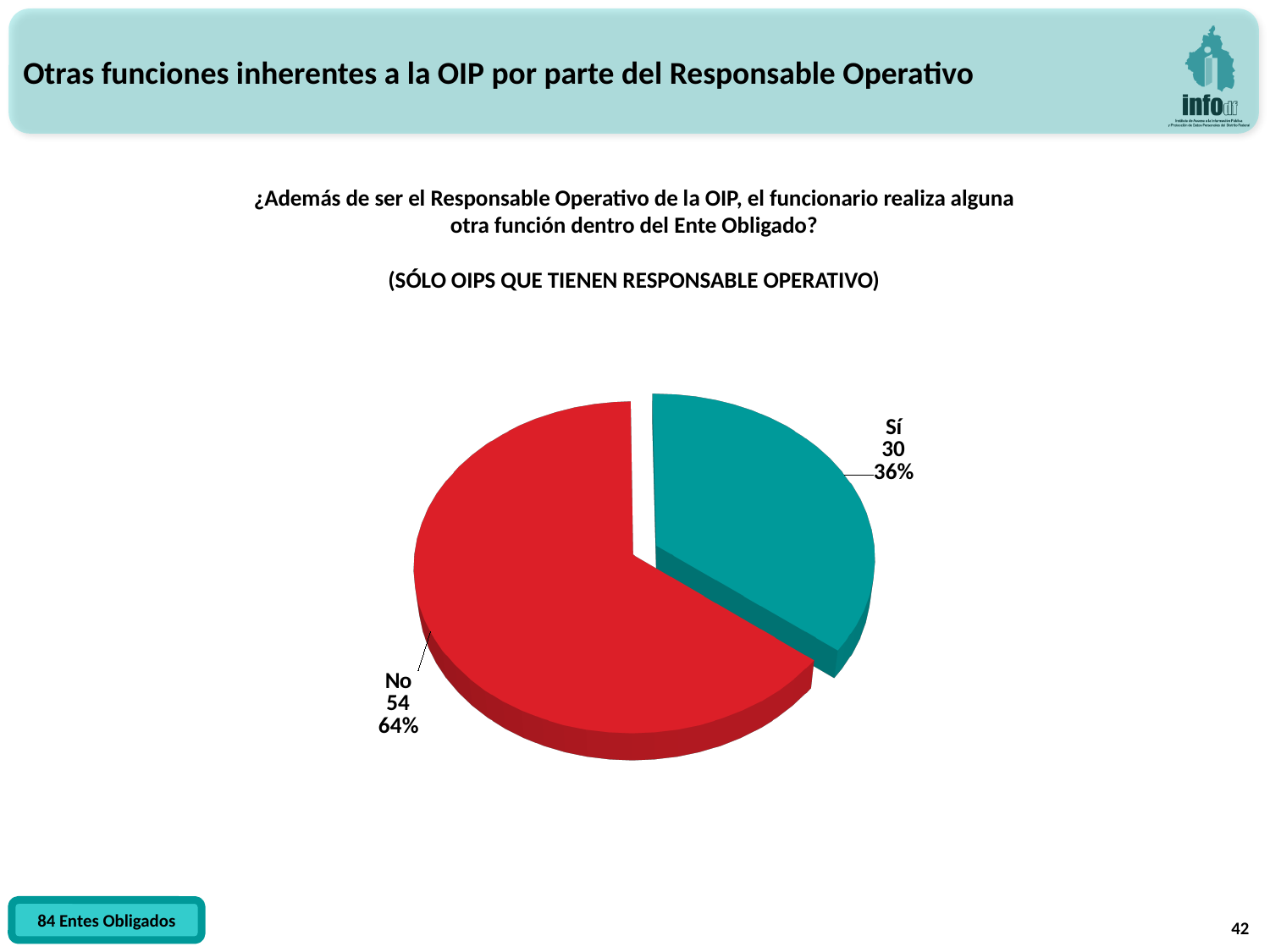
What percentage share does the "Sí" slice represent? 36% What is the value for the "Sí" slice? 30 How many slices does the pie chart have? 2 What is the total of the two slices in the pie chart? 84 What colour is the "Sí" slice? teal What is the difference between the "No" and "Sí" values? 24 Which is larger, the "Sí" slice or the "No" slice? No What kind of chart is shown on the slide? pie chart Which slice is the largest? No What percentage share does the "No" slice represent? 64% Which slice is the smallest? Sí What is the value for the "No" slice? 54